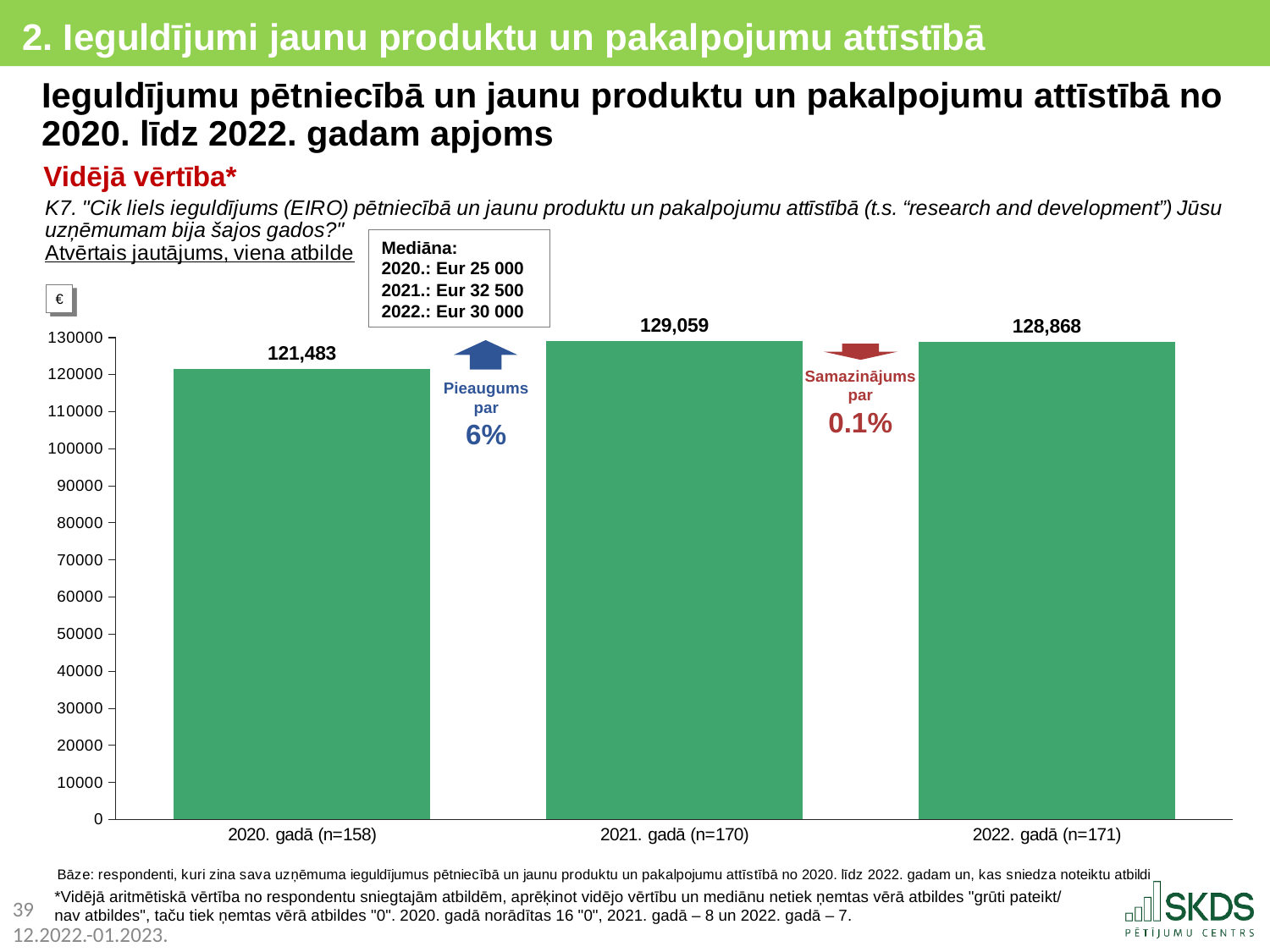
What is the value for 2022. gadā (n=171)? 128,868 What kind of chart is shown on the slide? bar chart What is the difference between the values for 2021. gadā (n=170) and 2020. gadā (n=158)? 7,576 What is the value for 2020. gadā (n=158)? 121,483 How many bars are shown in the chart? 3 Which year has the highest value? 2021. gadā (n=170) Is the value for 2020. gadā (n=158) greater or less than 120000? greater According to the median box on the slide, what is the median for 2021? Eur 32 500 Which is larger, the value for 2020. gadā (n=158) or the value for 2022. gadā (n=171)? 2022. gadā (n=171) Which year has the lowest value? 2020. gadā (n=158) By what percentage did the value increase from 2020 to 2021, according to the annotation on the chart? 6% What is the value for 2021. gadā (n=170)? 129,059